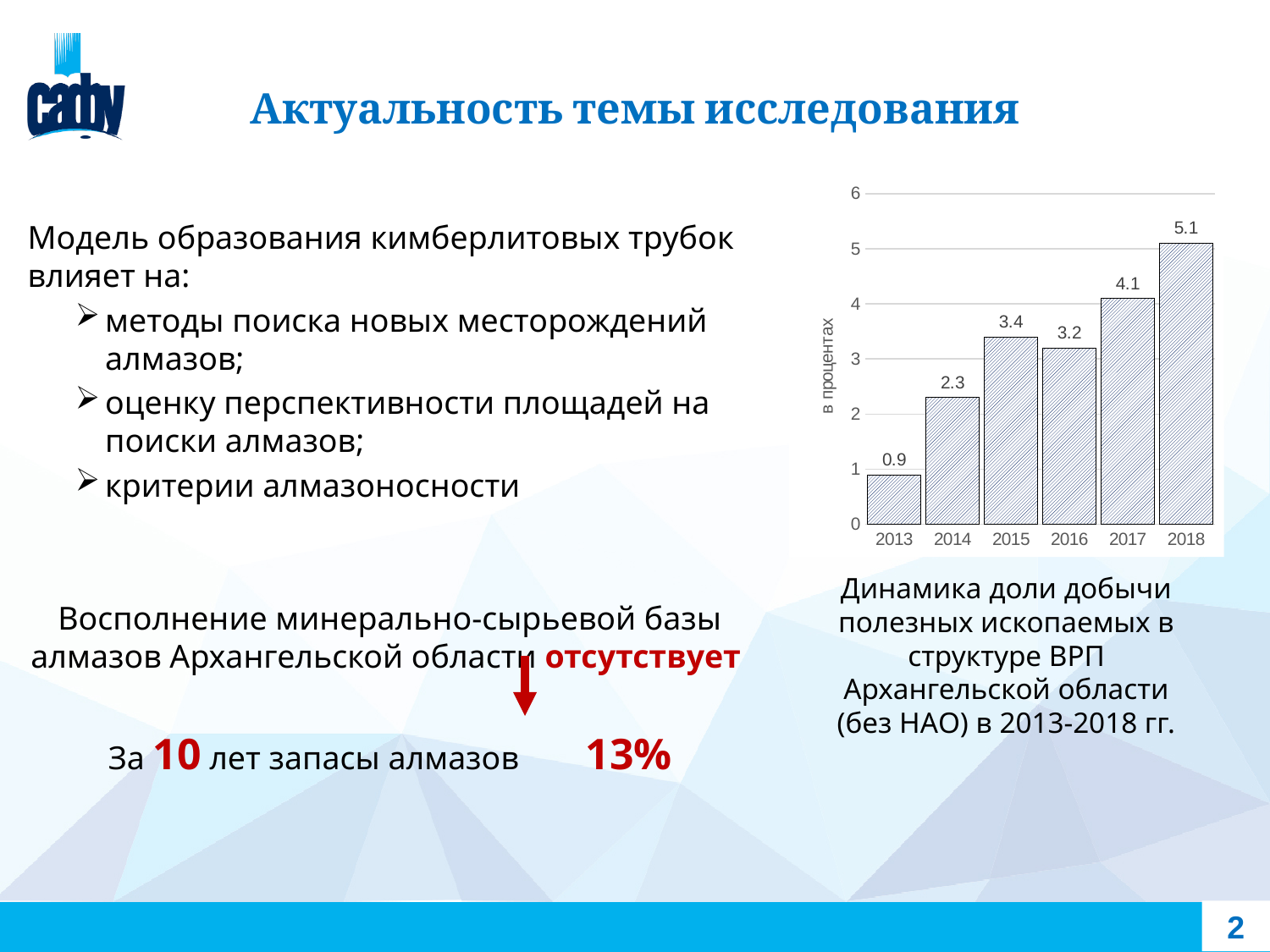
What is the difference between the values for 2015 and 2014? 1.1 What is the value for 2018 in the bar chart? 5.1 What is the value for 2016 in the bar chart? 3.2 Which year has the lowest value in the bar chart? 2013 How many years are shown on the x axis of the bar chart? 6 Does the value rise or fall from 2013 to 2015? rise What is the difference between the values for 2018 and 2017? 1.0 What is the value for 2013 in the bar chart? 0.9 Which is larger, the value for 2015 or the value for 2016? 2015 What kind of chart is shown on the slide? bar chart Which year has the highest value in the bar chart? 2018 What is the label of the vertical axis of the bar chart? в процентах